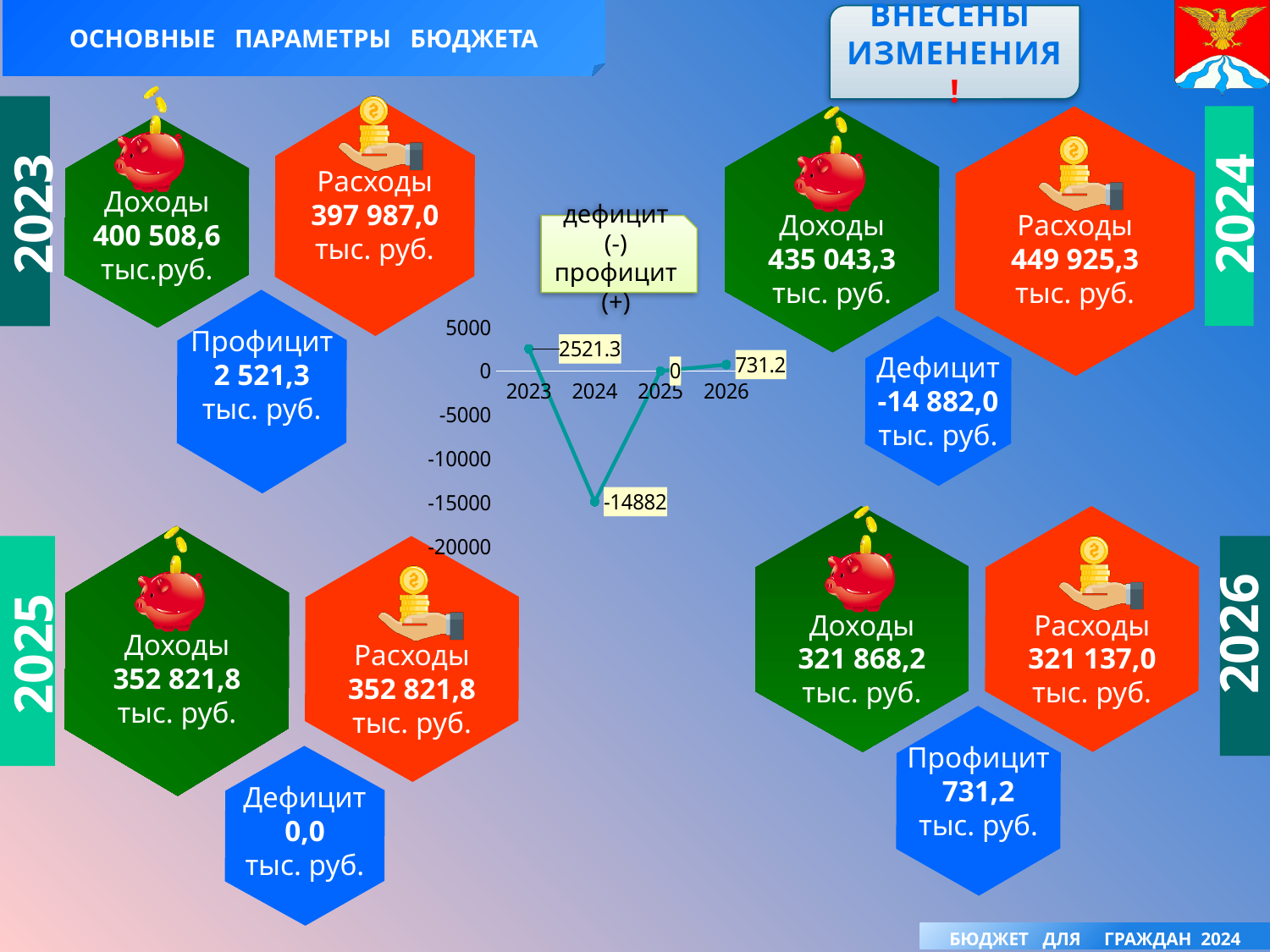
What is the value plotted for 2026 on the line chart? 731.2 What is the value plotted for 2023 on the line chart? 2521.3 Is the value for 2023 on the line chart larger than the value for 2026? Yes, 2023 What is the title shown above the line chart? дефицит (-) профицит (+) What is the value plotted for 2024 on the line chart? -14882 Which year has the highest value on the line chart? 2023 Which year has the lowest value on the line chart? 2024 What type of chart is shown in the centre of the slide? line chart How many years are plotted on the line chart? 4 What is the value plotted for 2025 on the line chart? 0 Does the line chart rise or fall from 2023 to 2024? fall What is the difference between the values for 2023 and 2026 on the line chart? 1790.1